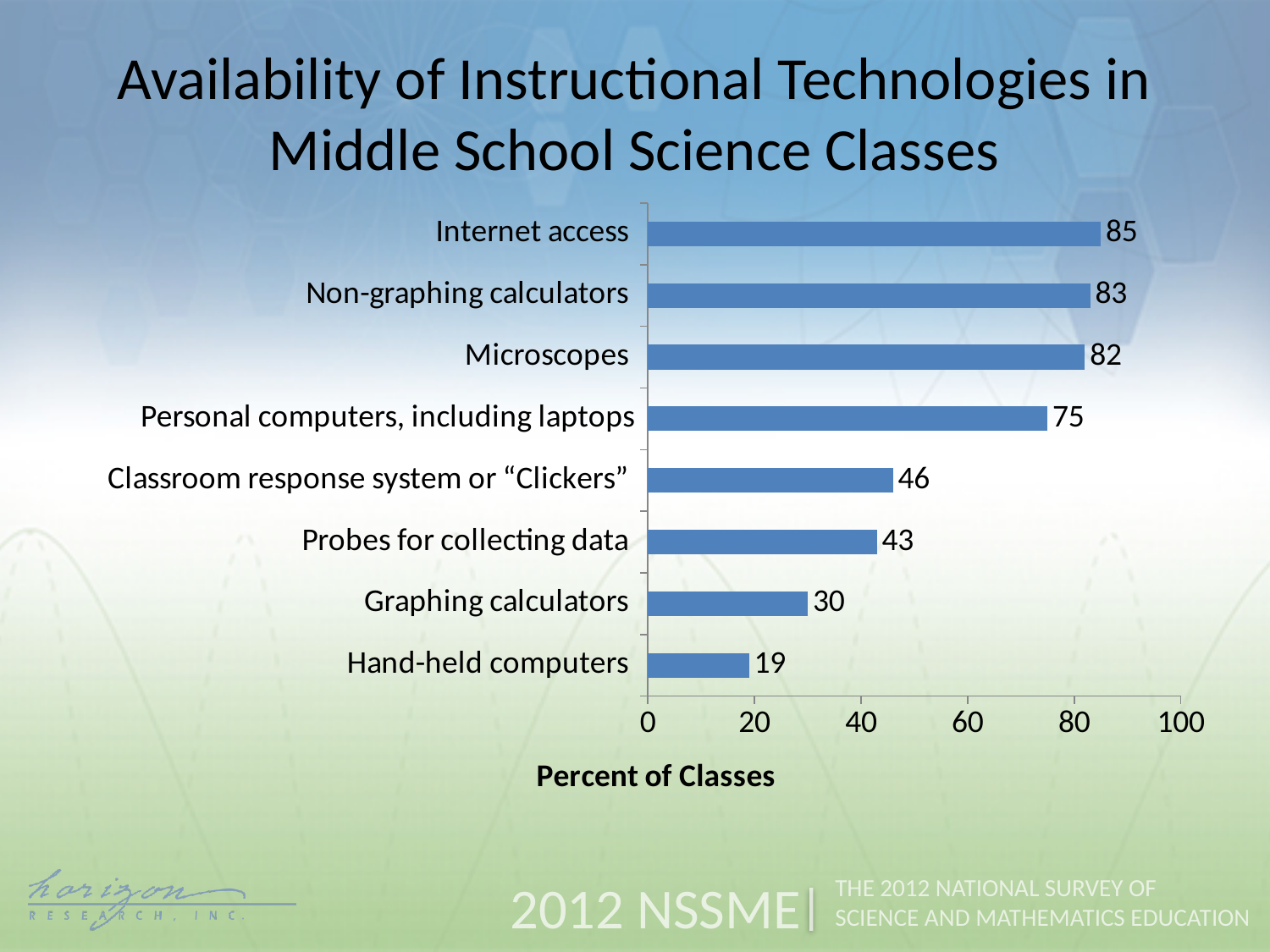
What is the value for Probes for collecting data? 43 Which is larger, the value for Classroom response system or "Clickers" or the value for Probes for collecting data? Classroom response system or "Clickers" What is the label of the horizontal axis? Percent of Classes How many instructional technologies are shown in the chart? 8 What is the value for Graphing calculators? 30 What is the difference between the values for Personal computers, including laptops and Graphing calculators? 45 Which instructional technology has the lowest availability? Hand-held computers What percent of classes have Internet access available? 85 Is the value for Microscopes greater or less than 60? greater What kind of chart is shown on the slide? Bar chart Which instructional technology has the highest availability? Internet access What is the difference between the values for Internet access and Hand-held computers? 66